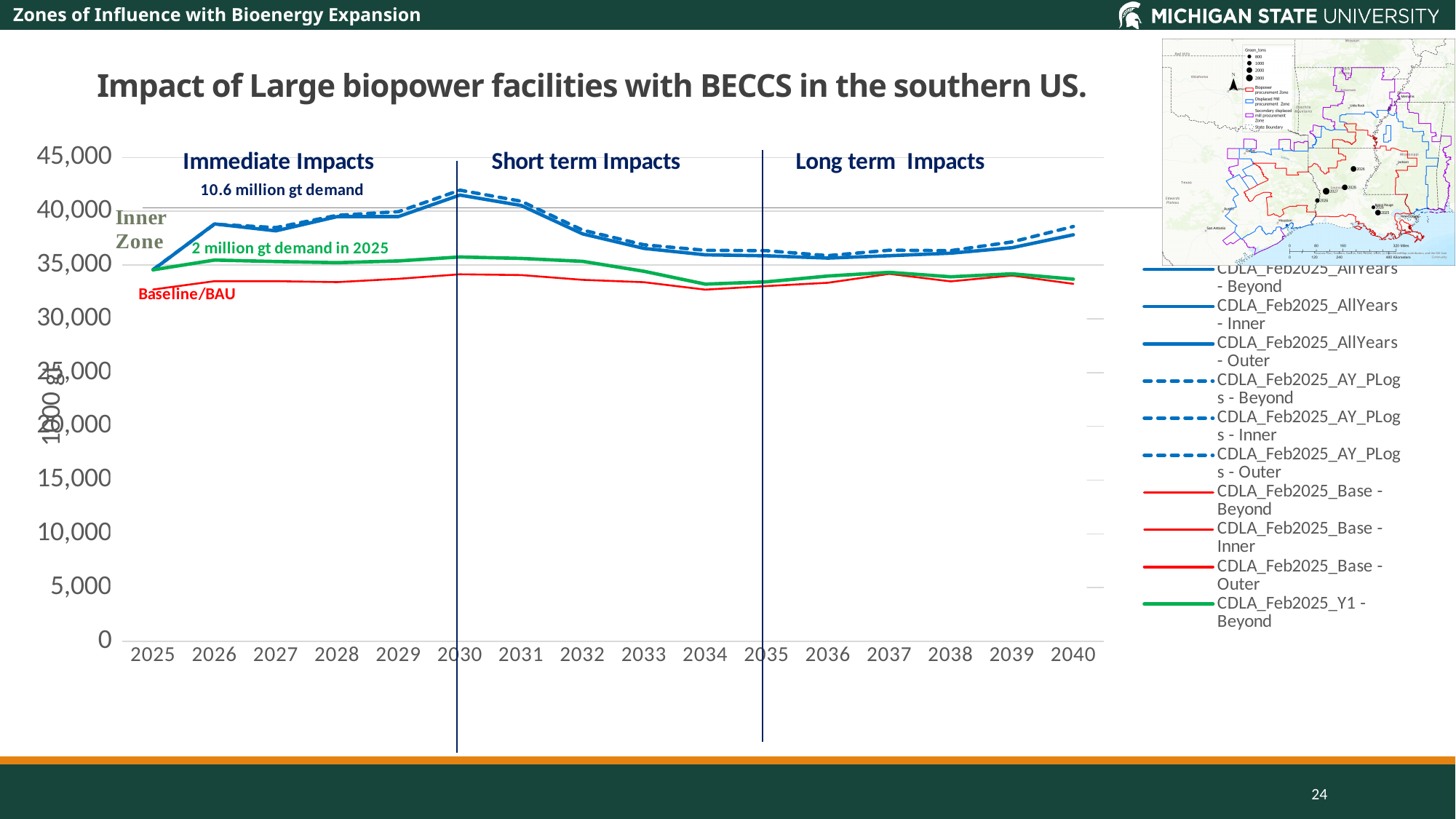
In which year does the solid blue line reach its highest value? 2030 Does the solid blue line rise or fall between 2030 and 2034? Fall What is the last year shown on the x axis? 2040 Is the value of the solid blue line in 2040 greater or less than 35,000? greater Is the value of the solid blue line in 2030 greater or less than 40,000? greater Is the value of the red Baseline/BAU line in 2025 greater or less than 35,000? less What kind of chart is shown on the slide? Line chart How many series does the chart legend list? 10 What is the first year shown on the x axis? 2025 In 2030, which is larger: the solid blue line or the red Baseline/BAU line? The solid blue line What is the title of the chart? Impact of Large biopower facilities with BECCS in the southern US. How many years are shown along the x axis of the chart? 16